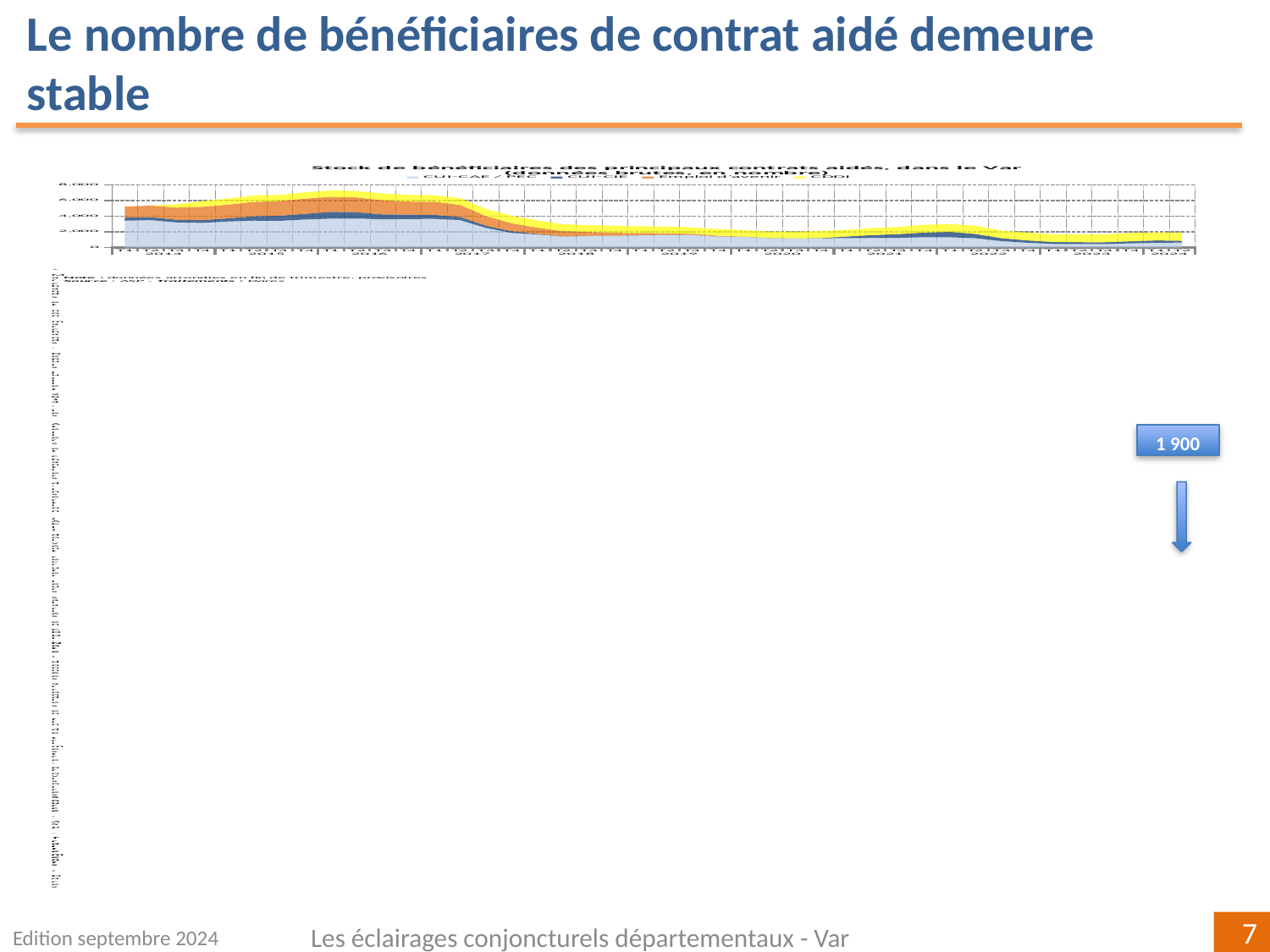
Is the total stock of beneficiaries higher in 2015 or in 2022? 2015 Is the total stock of beneficiaries in 2020 greater or less than 4,000? less What is the highest value shown on the vertical axis of the chart? 8,000 What kind of chart is shown on the slide? stacked area chart How many years are labelled along the x axis of the chart? 11 In which year does the total stock of beneficiaries reach its highest level? 2016 Which series is shown in yellow in the chart? CDDI How many series does the legend of the chart list? 4 What is the title of the chart? Stock de bénéficiaires des principaux contrats aidés, dans le Var (données brutes, en nombre) Is the total stock of beneficiaries at the start of 2014 greater or less than 2,000? greater Does the total stock of beneficiaries rise or fall between 2016 and 2024? fall Is the total stock of beneficiaries in 2016 greater or less than 4,000? greater